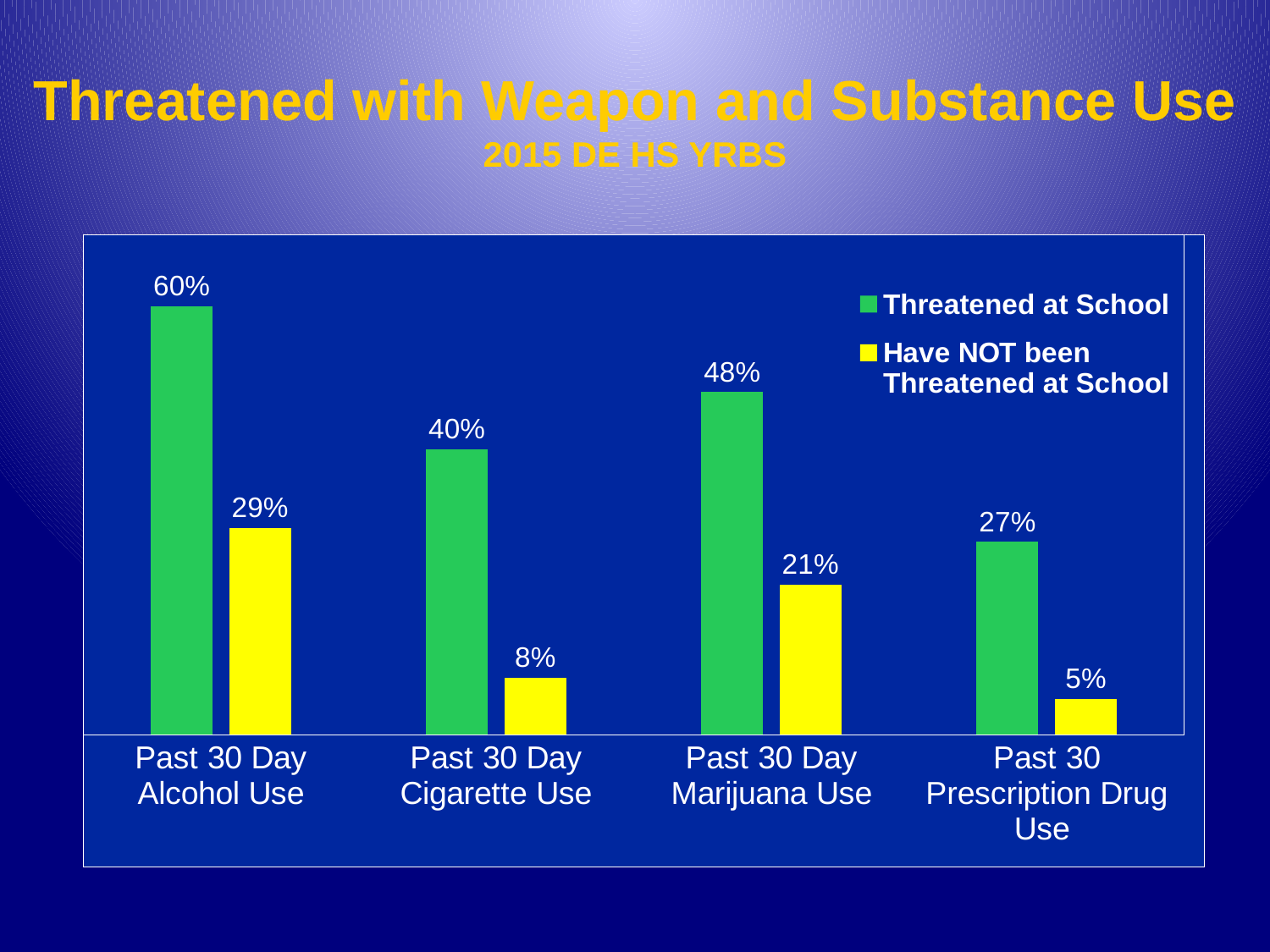
What is the value for past 30 prescription drug use among students who have NOT been threatened at school? 5% Which category has the lowest value for the Have NOT been Threatened at School series? Past 30 Prescription Drug Use How many substance use categories are shown on the x axis? 4 What is the difference between the Threatened at School and Have NOT been Threatened at School values for past 30 day alcohol use? 31% Which is larger: the Threatened at School value for past 30 day cigarette use or the Have NOT been Threatened at School value for past 30 day alcohol use? Threatened at School value for past 30 day cigarette use How many series does the legend list? 2 What percentage of students threatened at school reported past 30 day alcohol use? 60% What percentage of students threatened at school reported past 30 day marijuana use? 48% What kind of chart is shown on the slide? Bar chart What is the difference between the Threatened at School and Have NOT been Threatened at School values for past 30 day marijuana use? 27% What is the value for past 30 day cigarette use among students who have NOT been threatened at school? 8% Which category has the highest value for the Threatened at School series? Past 30 Day Alcohol Use